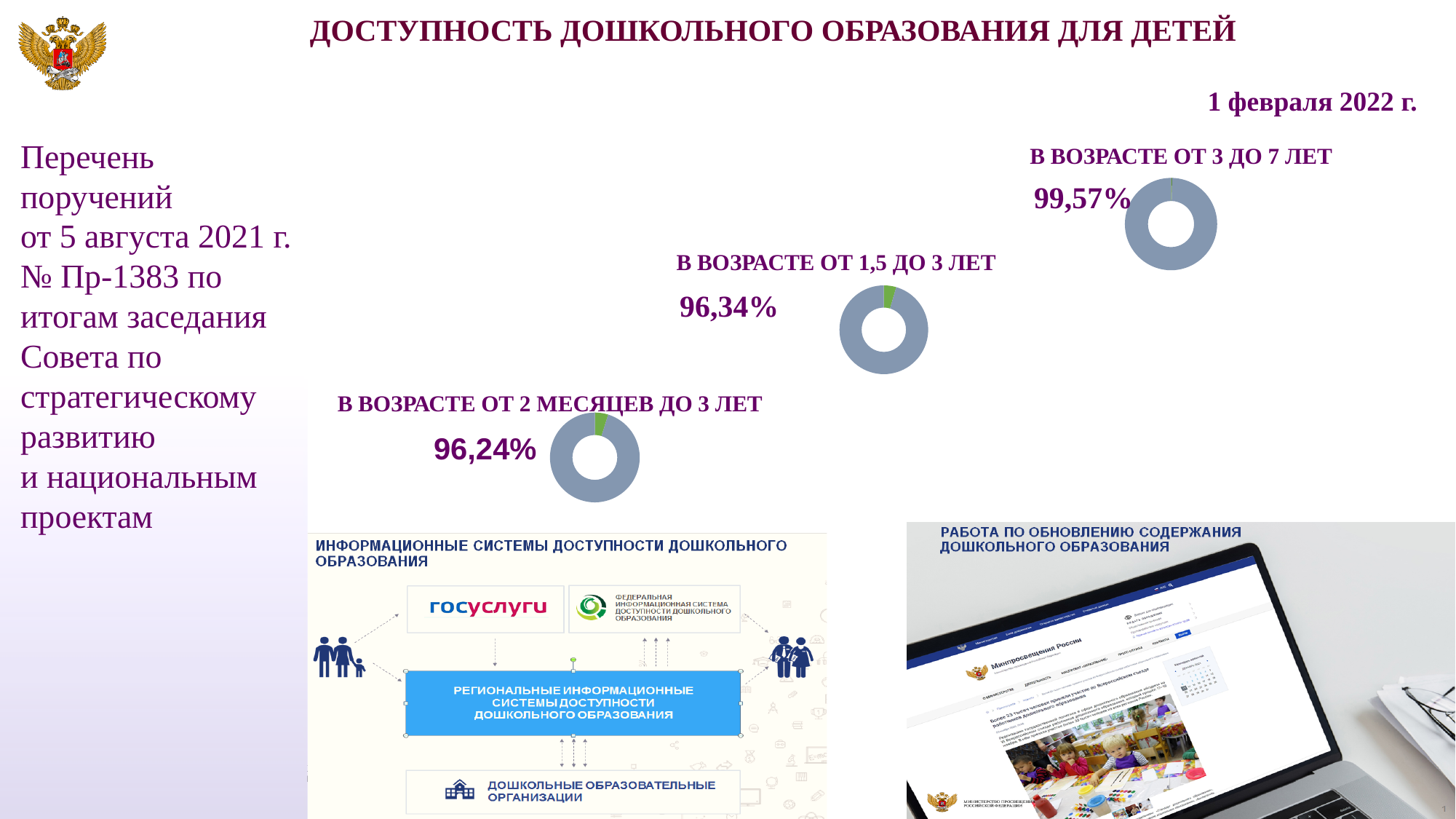
Which is larger: the value for 'В ВОЗРАСТЕ ОТ 3 ДО 7 ЛЕТ' or the value for 'В ВОЗРАСТЕ ОТ 2 МЕСЯЦЕВ ДО 3 ЛЕТ'? В ВОЗРАСТЕ ОТ 3 ДО 7 ЛЕТ What kind of chart is used to show the percentages for each age group? Donut (pie) chart What colour is the large segment in each donut chart? Grey-blue What value is shown for the chart 'В ВОЗРАСТЕ ОТ 2 МЕСЯЦЕВ ДО 3 ЛЕТ'? 96,24% How many donut charts are shown on the slide? 3 Which age group chart shows the lowest percentage? В ВОЗРАСТЕ ОТ 2 МЕСЯЦЕВ ДО 3 ЛЕТ What value is shown for the chart 'В ВОЗРАСТЕ ОТ 1,5 ДО 3 ЛЕТ'? 96,34% Which age group chart shows the highest percentage? В ВОЗРАСТЕ ОТ 3 ДО 7 ЛЕТ What is the difference between the value for 'В ВОЗРАСТЕ ОТ 1,5 ДО 3 ЛЕТ' and the value for 'В ВОЗРАСТЕ ОТ 2 МЕСЯЦЕВ ДО 3 ЛЕТ'? 0,10% What is the difference between the value for 'В ВОЗРАСТЕ ОТ 3 ДО 7 ЛЕТ' and the value for 'В ВОЗРАСТЕ ОТ 2 МЕСЯЦЕВ ДО 3 ЛЕТ'? 3,33% What value is shown for the chart 'В ВОЗРАСТЕ ОТ 3 ДО 7 ЛЕТ'? 99,57% What is the difference between the value for 'В ВОЗРАСТЕ ОТ 3 ДО 7 ЛЕТ' and the value for 'В ВОЗРАСТЕ ОТ 1,5 ДО 3 ЛЕТ'? 3,23%